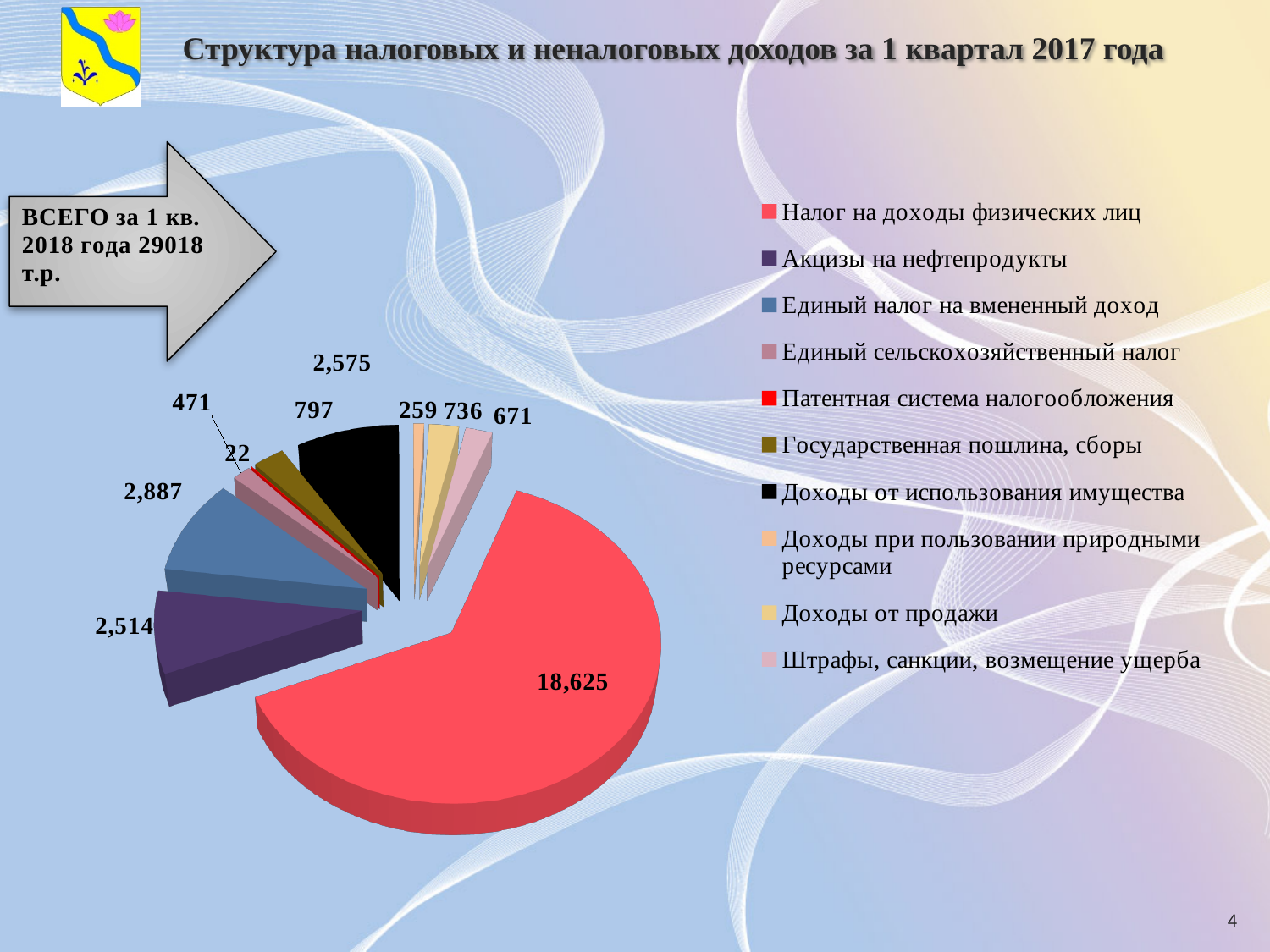
What is the value for Патентная система налогообложения? 22 What is the value for Налог на доходы физических лиц? 18,625 What is the value for Единый налог на вмененный доход? 2,887 What is the value for Доходы от использования имущества? 2,575 Which is larger: Государственная пошлина, сборы or Штрафы, санкции, возмещение ущерба? Государственная пошлина, сборы How many categories does the legend list? 10 What is the difference between the values for Единый налог на вмененный доход and Акцизы на нефтепродукты? 373 What kind of chart is shown on the slide? pie chart Which category has the smallest slice of the pie? Патентная система налогообложения What is the value for Доходы от продажи? 736 Which category has the largest slice of the pie? Налог на доходы физических лиц What is the title of the slide? Структура налоговых и неналоговых доходов за 1 квартал 2017 года